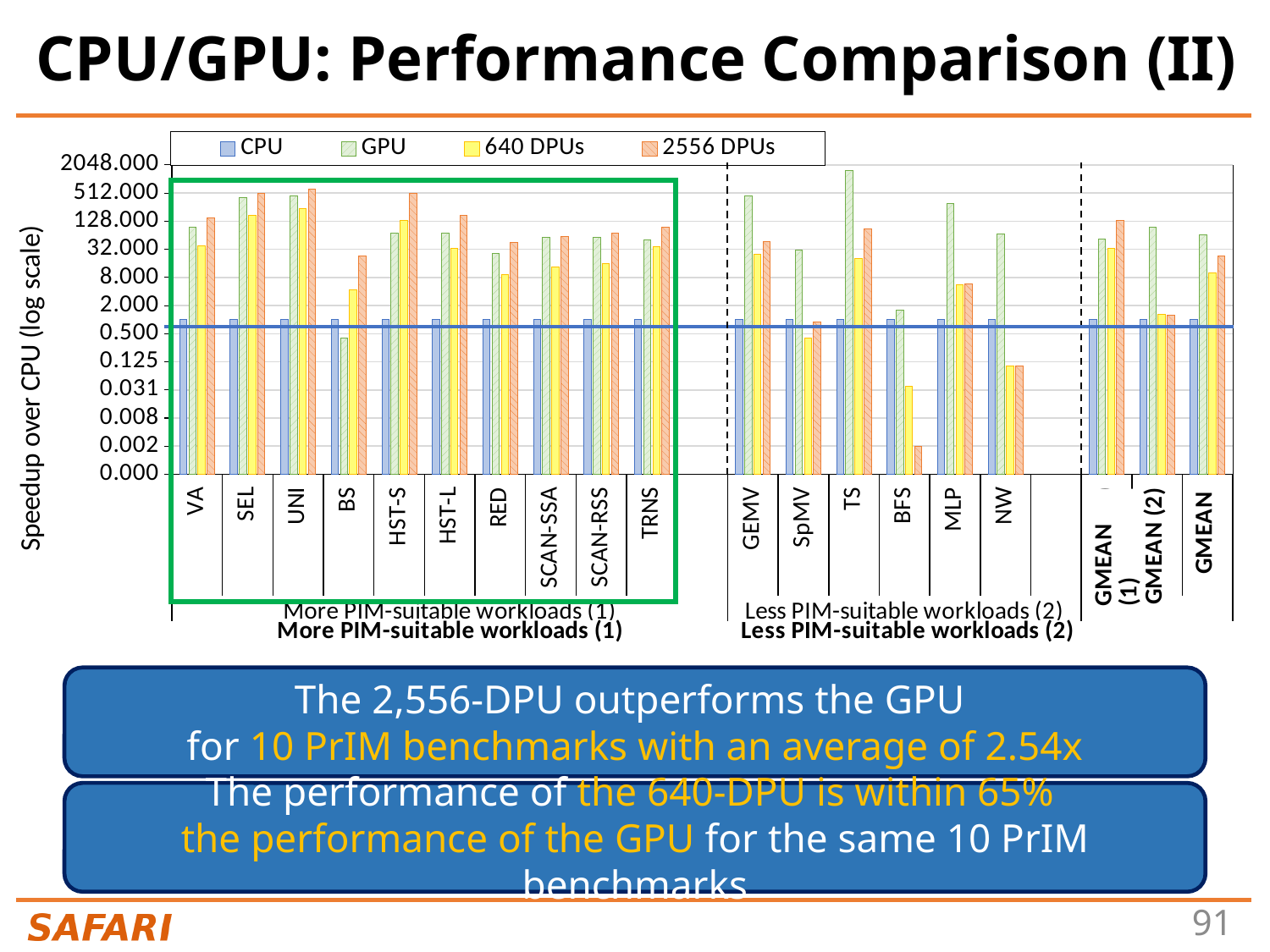
Is the 2556 DPUs value for BFS greater or less than 0.008? less Is the 640 DPUs value for NW greater or less than 0.500? less Is the GPU value for TS greater or less than 512.000? greater Which workload has the lowest 2556 DPUs bar in the chart? BFS What are the series listed in the chart legend? CPU, GPU, 640 DPUs, 2556 DPUs What is the label of the y axis of the chart? Speedup over CPU (log scale) For MLP, which is larger: the GPU value or the 2556 DPUs value? GPU Which workload has the highest GPU bar in the chart? TS For VA, which is larger: the GPU value or the 2556 DPUs value? 2556 DPUs What kind of chart is shown on the slide? bar chart How many series does the chart legend list? 4